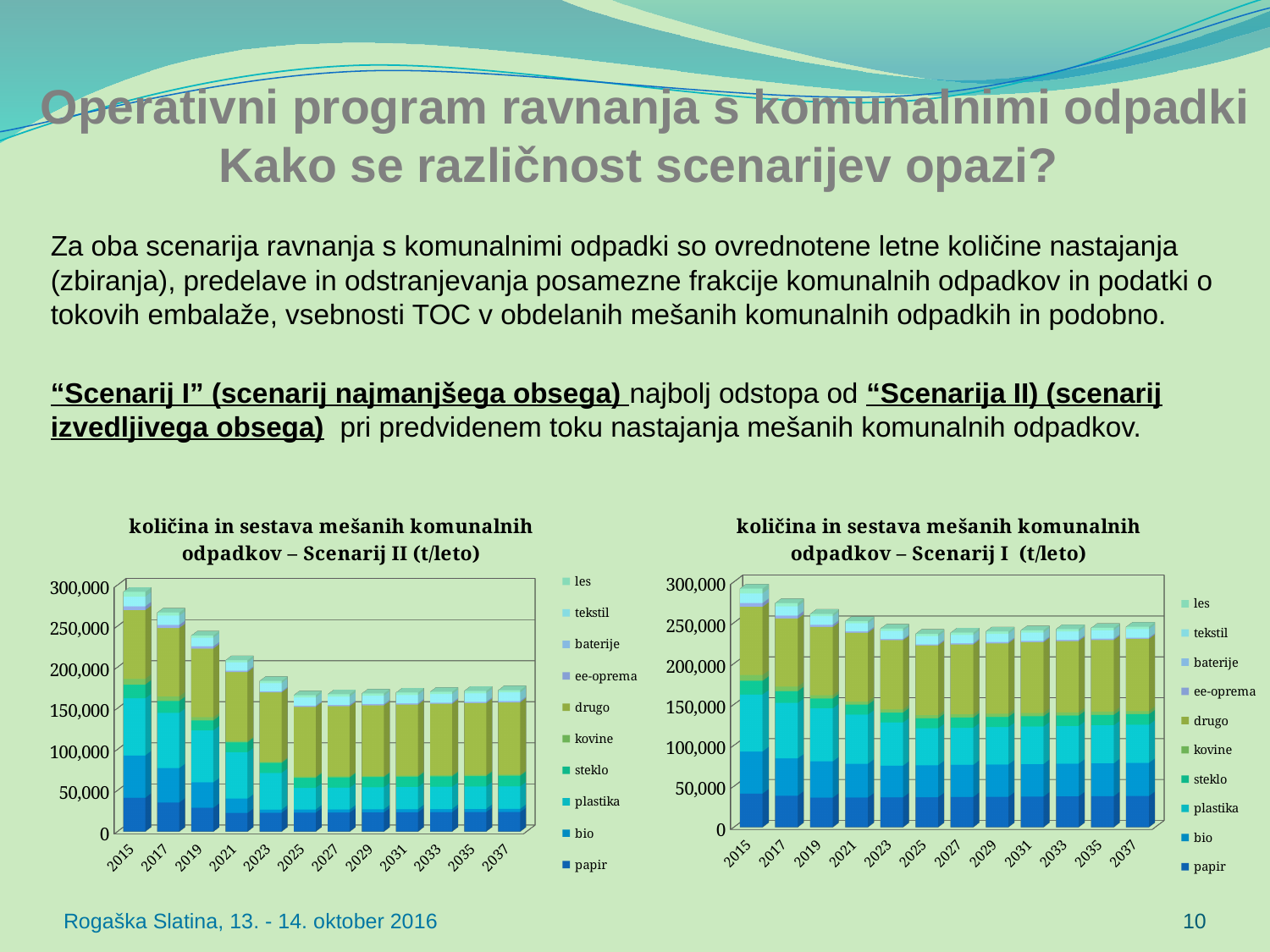
In the right chart (Scenarij I), is the total for 2037 greater or less than 200,000? greater In the right chart (Scenarij I), which is larger: the total for 2015 or the total for 2037? 2015 In the right chart (Scenarij I), which year has the highest total bar? 2015 How many bars are plotted in the left chart (Scenarij II)? 12 In the left chart (Scenarij II), is the total for 2015 greater or less than 250,000? greater How many series does the legend of the right chart (Scenarij I) list? 10 In the left chart (Scenarij II), is the total for 2037 greater or less than 200,000? less Which is larger: the total for 2037 in the right chart (Scenarij I) or the total for 2037 in the left chart (Scenarij II)? Scenarij I What kind of chart is the left chart titled "količina in sestava mešanih komunalnih odpadkov – Scenarij II (t/leto)"? stacked bar chart In the left chart (Scenarij II), do the total bar heights rise or fall from 2015 to 2025? fall In the left chart (Scenarij II), which year has the highest total bar? 2015 Which legend entry is listed first (at the top) in the left chart (Scenarij II)? les